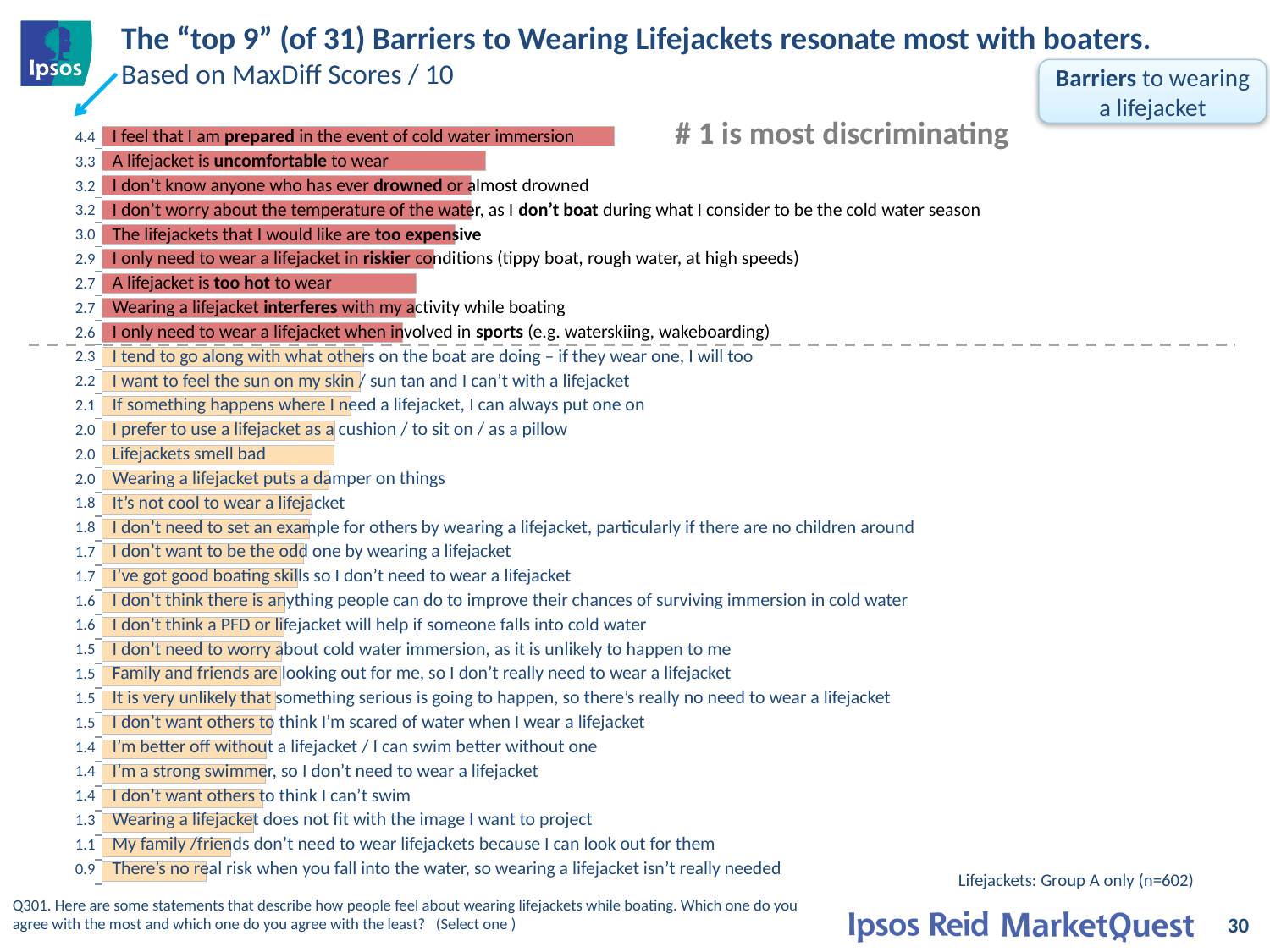
What is the MaxDiff score for "The lifejackets that I would like are too expensive"? 3.0 What is the difference between the MaxDiff scores for "I don't want others to think I can't swim" and "My family / friends don't need to wear lifejackets because I can look out for them"? 0.3 What is the MaxDiff score for "I feel that I am prepared in the event of cold water immersion"? 4.4 What is the MaxDiff score for "Lifejackets smell bad"? 2.0 What is the difference between the MaxDiff scores for "I feel that I am prepared in the event of cold water immersion" and "A lifejacket is uncomfortable to wear"? 1.1 What kind of chart is shown on the slide? Bar chart Which barrier has the highest MaxDiff score? I feel that I am prepared in the event of cold water immersion How many barrier statements are plotted in the chart? 31 What is the MaxDiff score for "A lifejacket is uncomfortable to wear"? 3.3 Which has a higher MaxDiff score: "A lifejacket is too hot to wear" or "It's not cool to wear a lifejacket"? A lifejacket is too hot to wear How many bars are highlighted in red as the top barriers? 9 Which barrier has the lowest MaxDiff score? There's no real risk when you fall into the water, so wearing a lifejacket isn't really needed